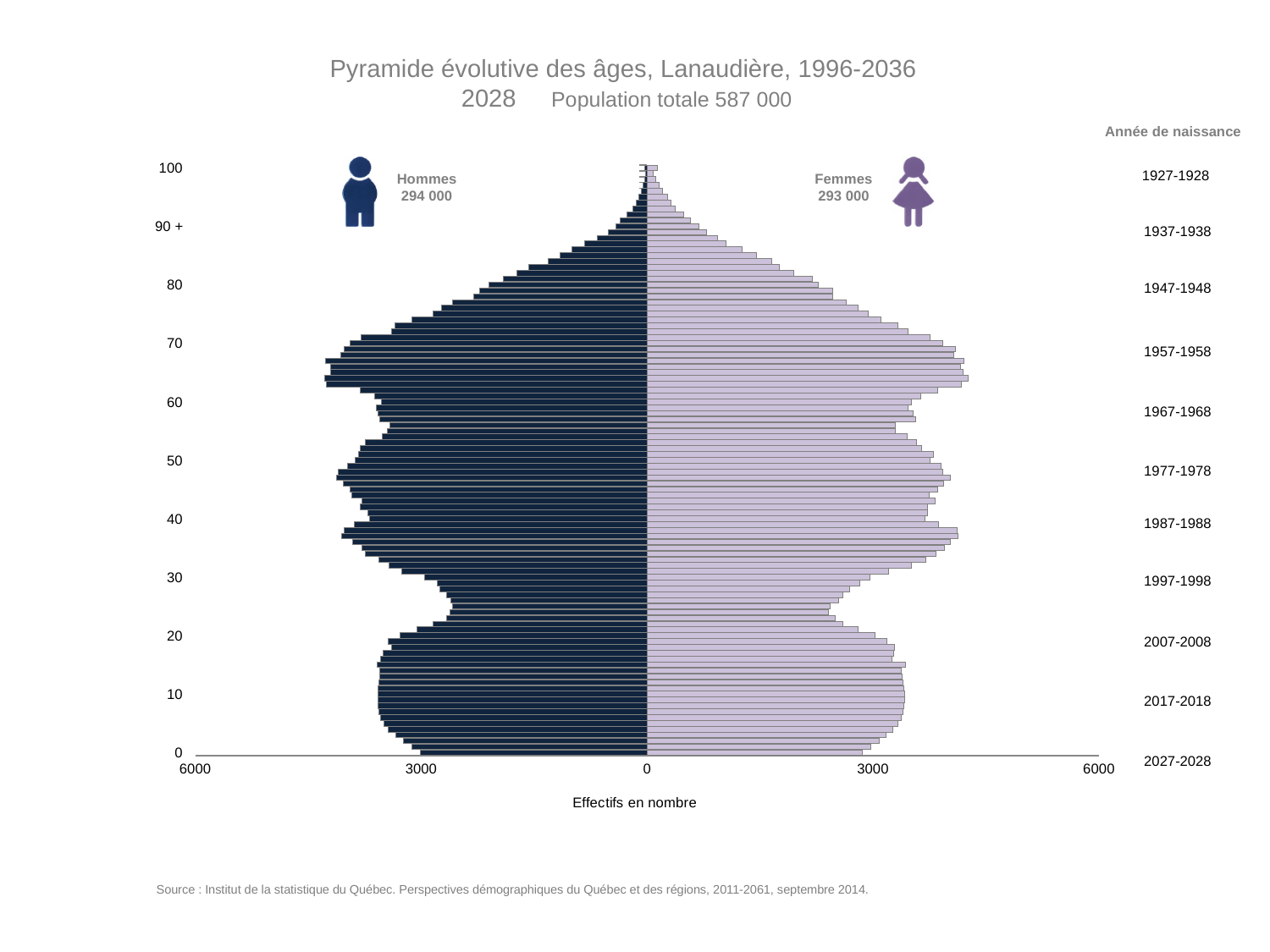
Is the value for women aged 25 greater or less than 3000? less Is the value for men aged 65 greater or less than 3000? greater What is the total population shown for 2028 on the slide? 587 000 What is the title of the chart? Pyramide évolutive des âges, Lanaudière, 1996-2036 What is the label of the horizontal axis? Effectifs en nombre What is the difference between the number of Hommes and the number of Femmes? 1 000 What is the number of Femmes (women) shown on the pyramid? 293 000 What kind of chart is shown on the slide? Bar chart (population pyramid) What is the number of Hommes (men) shown on the pyramid? 294 000 Which birth years correspond to age 0 on the right-hand axis? 2027-2028 Which group is larger, Hommes or Femmes? Hommes Is the value for women aged 90 greater or less than 3000? less